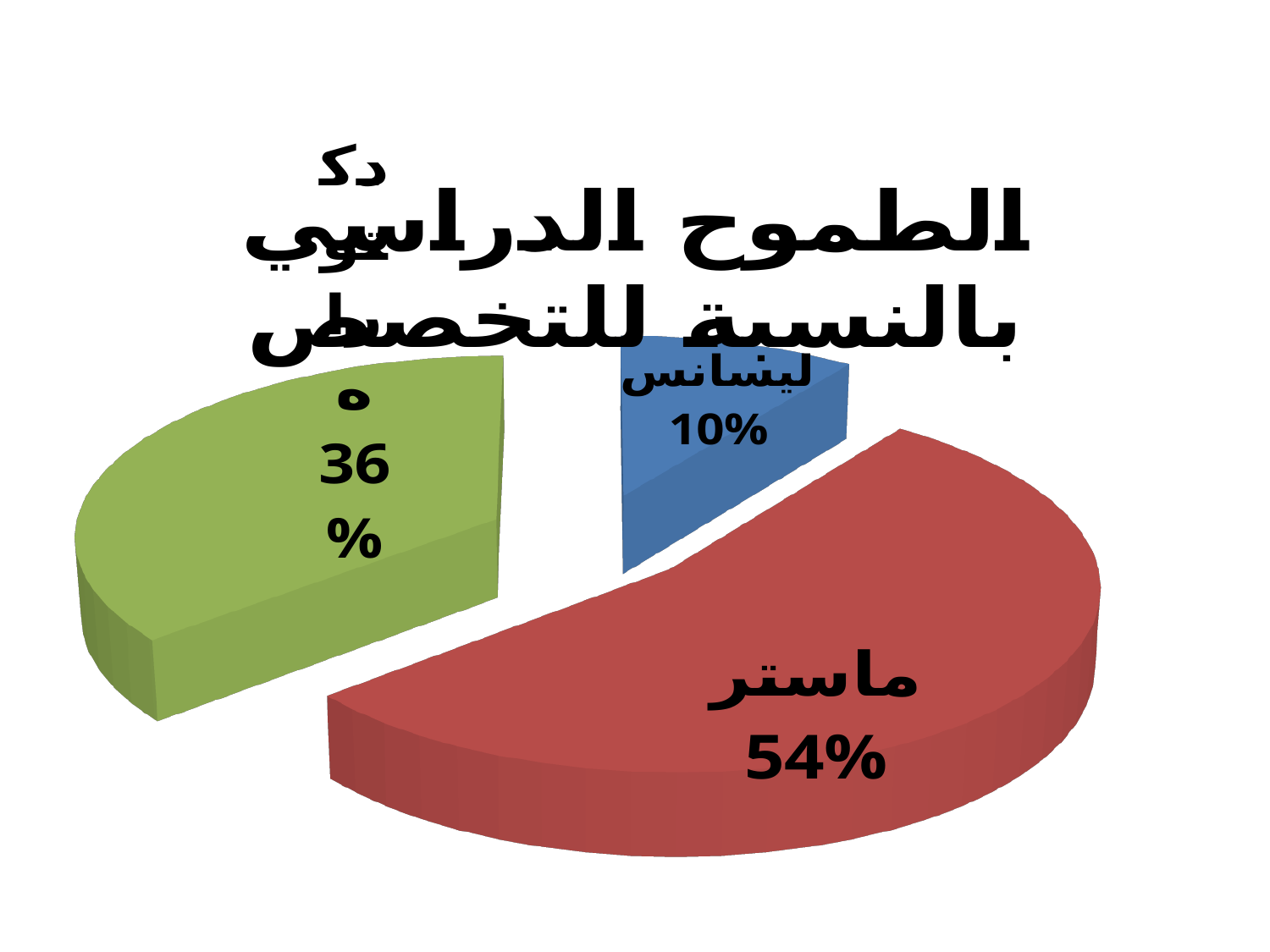
What percentage is shown for ماستر? 54% What percentage is shown on the green slice of the pie? 36% Which category has the largest share of the pie? ماستر How many slices does the pie chart have? 3 What kind of chart is shown on the slide? pie chart What is the difference in percentage points between ماستر and the green slice? 18 What colour is the ليسانس slice? blue Which is larger, the share for ماستر or the share for ليسانس? ماستر What colour is the ماستر slice? red What percentage is shown for ليسانس? 10% What is the difference in percentage points between ماستر and ليسانس? 44 Which category has the smallest share of the pie? ليسانس